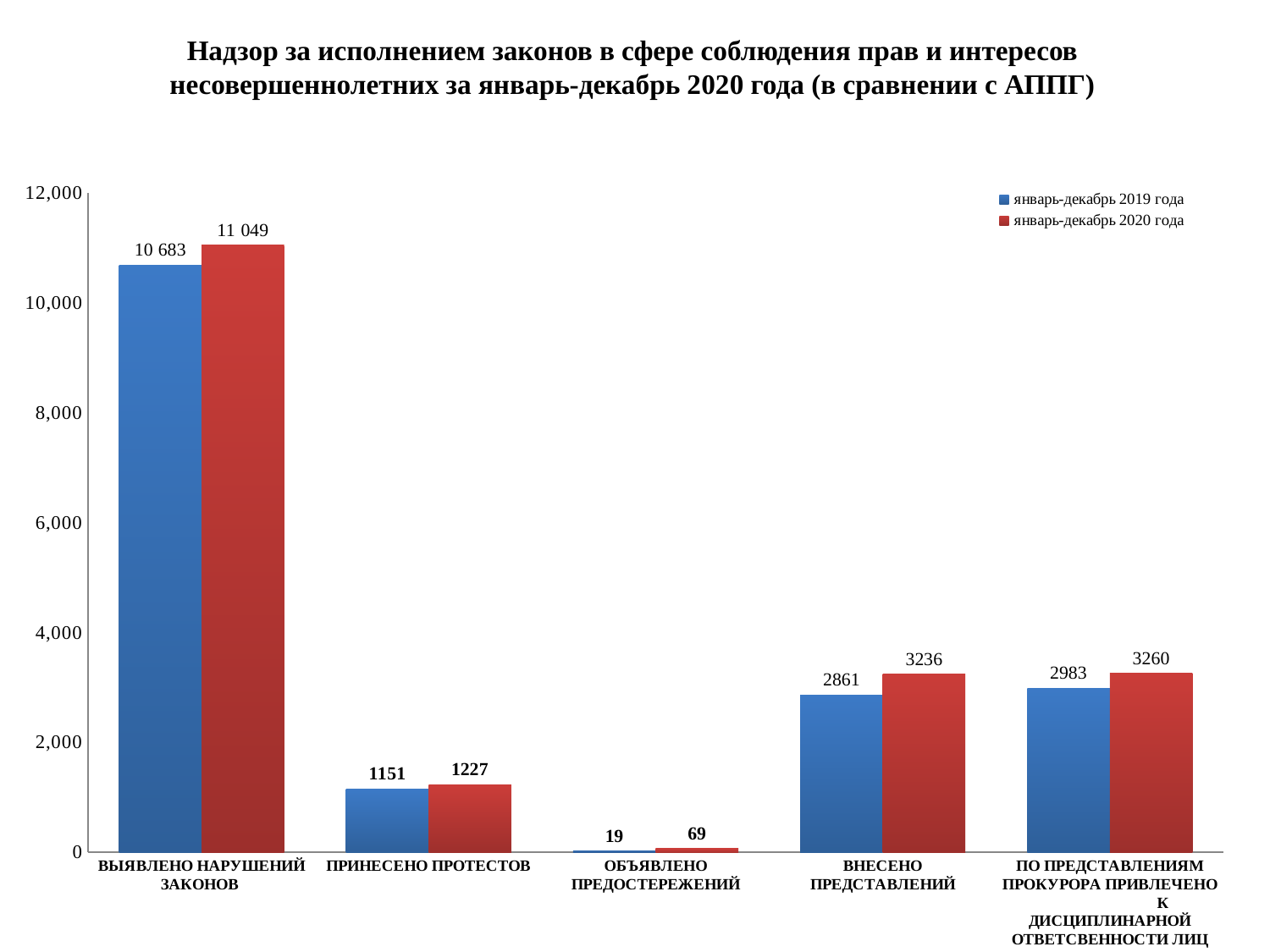
Which category has the highest value in the январь-декабрь 2020 года series? ВЫЯВЛЕНО НАРУШЕНИЙ ЗАКОНОВ What is the value for ОБЪЯВЛЕНО ПРЕДОСТЕРЕЖЕНИЙ in the январь-декабрь 2020 года series? 69 What is the difference between the 2020 and 2019 values for ОБЪЯВЛЕНО ПРЕДОСТЕРЕЖЕНИЙ? 50 What is the value for ВЫЯВЛЕНО НАРУШЕНИЙ ЗАКОНОВ in the январь-декабрь 2020 года series? 11 049 How many series does the legend list? 2 Which is larger for ПО ПРЕДСТАВЛЕНИЯМ ПРОКУРОРА ПРИВЛЕЧЕНО К ДИСЦИПЛИНАРНОЙ ОТВЕТСВЕННОСТИ ЛИЦ: the январь-декабрь 2019 года value or the январь-декабрь 2020 года value? январь-декабрь 2020 года What is the difference between the 2020 and 2019 values for ВНЕСЕНО ПРЕДСТАВЛЕНИЙ? 375 What kind of chart is shown on the slide? bar chart How many categories are shown on the x axis? 5 What is the value for ПРИНЕСЕНО ПРОТЕСТОВ in the январь-декабрь 2019 года series? 1151 What is the value for ВНЕСЕНО ПРЕДСТАВЛЕНИЙ in the январь-декабрь 2019 года series? 2861 Which category has the lowest value in the январь-декабрь 2019 года series? ОБЪЯВЛЕНО ПРЕДОСТЕРЕЖЕНИЙ